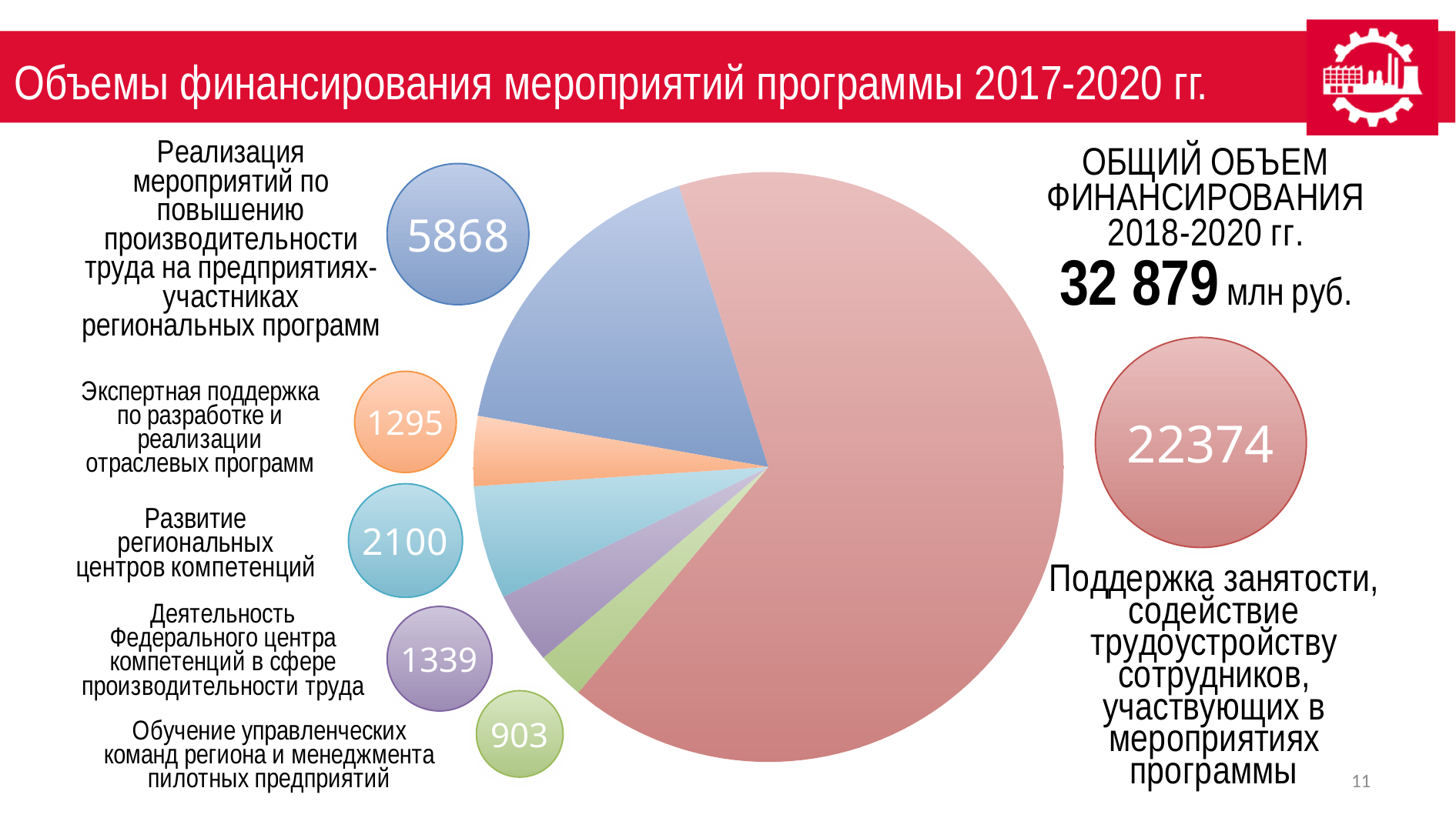
What is the value for 'Деятельность Федерального центра компетенций в сфере производительности труда'? 1339 How many slices does the pie chart have? 6 Which category has the smallest slice of the pie chart? Обучение управленческих команд региона и менеджмента пилотных предприятий What is the value for 'Поддержка занятости, содействие трудоустройству сотрудников, участвующих в мероприятиях программы'? 22374 Which is larger: the value for 'Деятельность Федерального центра компетенций' or for 'Экспертная поддержка по разработке и реализации отраслевых программ'? Деятельность Федерального центра компетенций (1339) Which category has the largest slice of the pie chart? Поддержка занятости, содействие трудоустройству сотрудников, участвующих в мероприятиях программы What is the value for 'Экспертная поддержка по разработке и реализации отраслевых программ'? 1295 What kind of chart is shown on the slide? Pie chart What total funding volume for 2018-2020 is stated on the slide? 32 879 млн руб. What is the value for 'Реализация мероприятий по повышению производительности труда на предприятиях-участниках региональных программ'? 5868 What is the value for 'Развитие региональных центров компетенций'? 2100 What is the difference between the value for 'Реализация мероприятий по повышению производительности труда' (5868) and 'Развитие региональных центров компетенций' (2100)? 3768